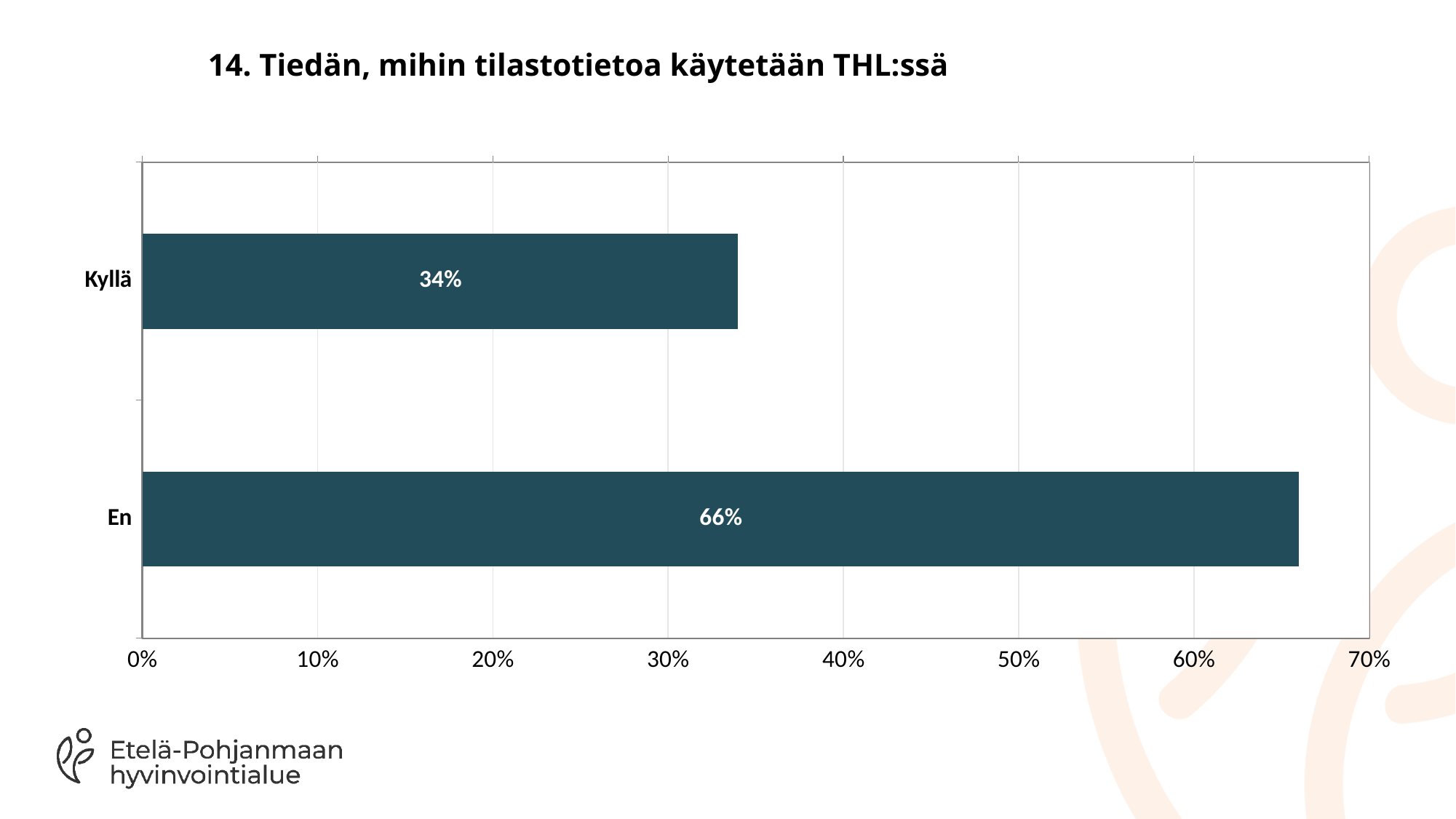
Which category has the highest value? En What is the title of the chart? 14. Tiedän, mihin tilastotietoa käytetään THL:ssä Which category has the lowest value? Kyllä How many categories are shown in the chart? 2 Is the value for En greater or less than 60%? greater What is the value for Kyllä? 34% What kind of chart is shown on the slide? bar chart What is the maximum value shown on the x axis? 70% What is the difference between the values for En and Kyllä? 32% Which is larger, the value for Kyllä or the value for En? En What is the value for En? 66% Is the value for Kyllä greater or less than 40%? less